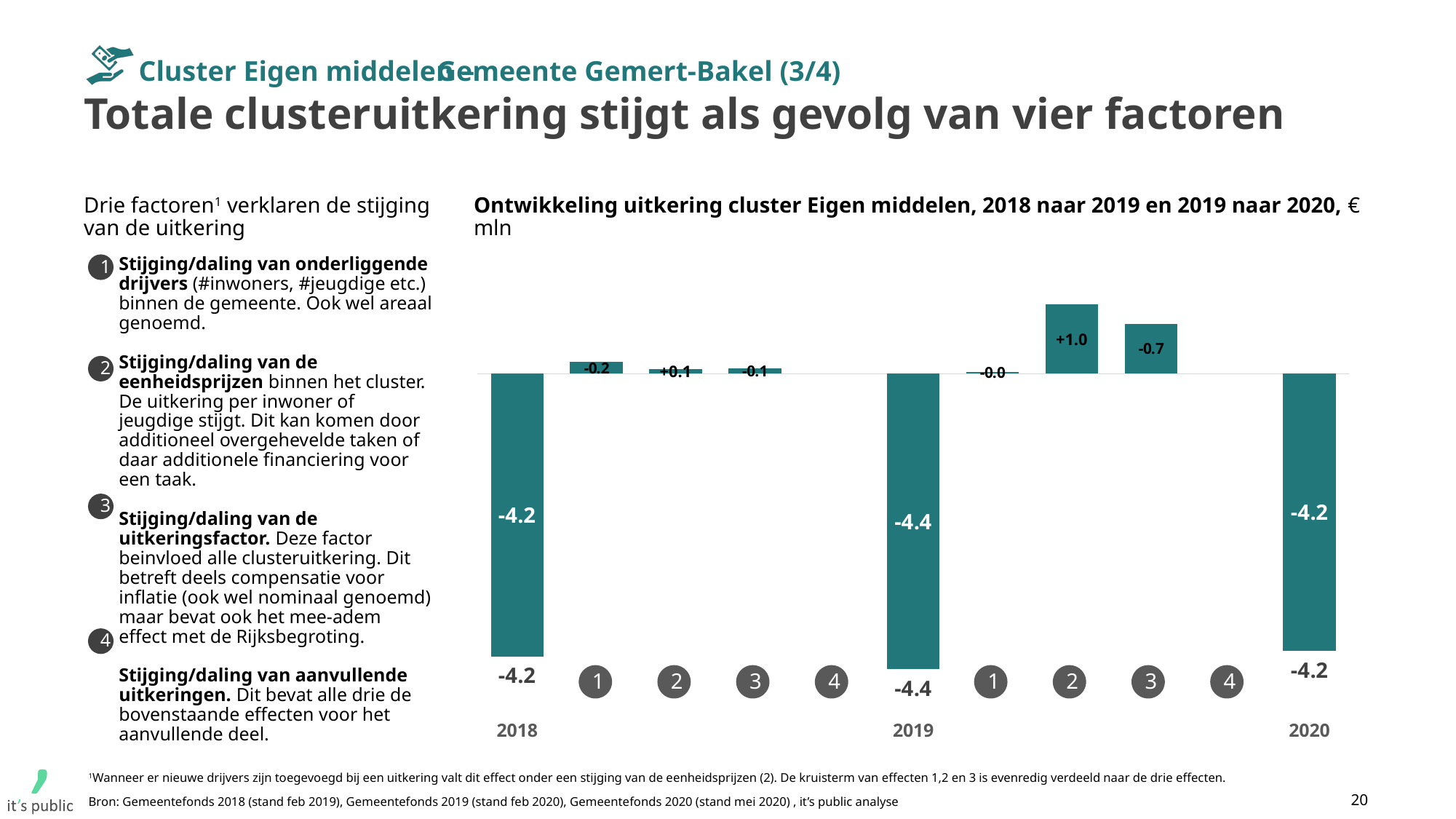
Which year has the lowest total value: 2018, 2019 or 2020? 2019 What is the value of the 2020 bar? -4.2 What is the value labelled on the factor 2 bar between 2019 and 2020? +1.0 What is the difference between the 2019 total and the 2018 total? -0.2 What is the value of the 2018 bar? -4.2 What is the value labelled on the factor 3 bar between 2019 and 2020? -0.7 Is the factor 2 effect between 2019 and 2020 larger or smaller than the factor 3 effect between 2019 and 2020 in absolute size? larger What is the value labelled on the factor 1 bar between 2018 and 2019? -0.2 How many year totals (2018, 2019, 2020) are shown in the chart? 3 What is the value labelled on the factor 2 bar between 2018 and 2019? +0.1 What is the value of the 2019 bar? -4.4 What kind of chart is shown on the slide? bar chart (waterfall)